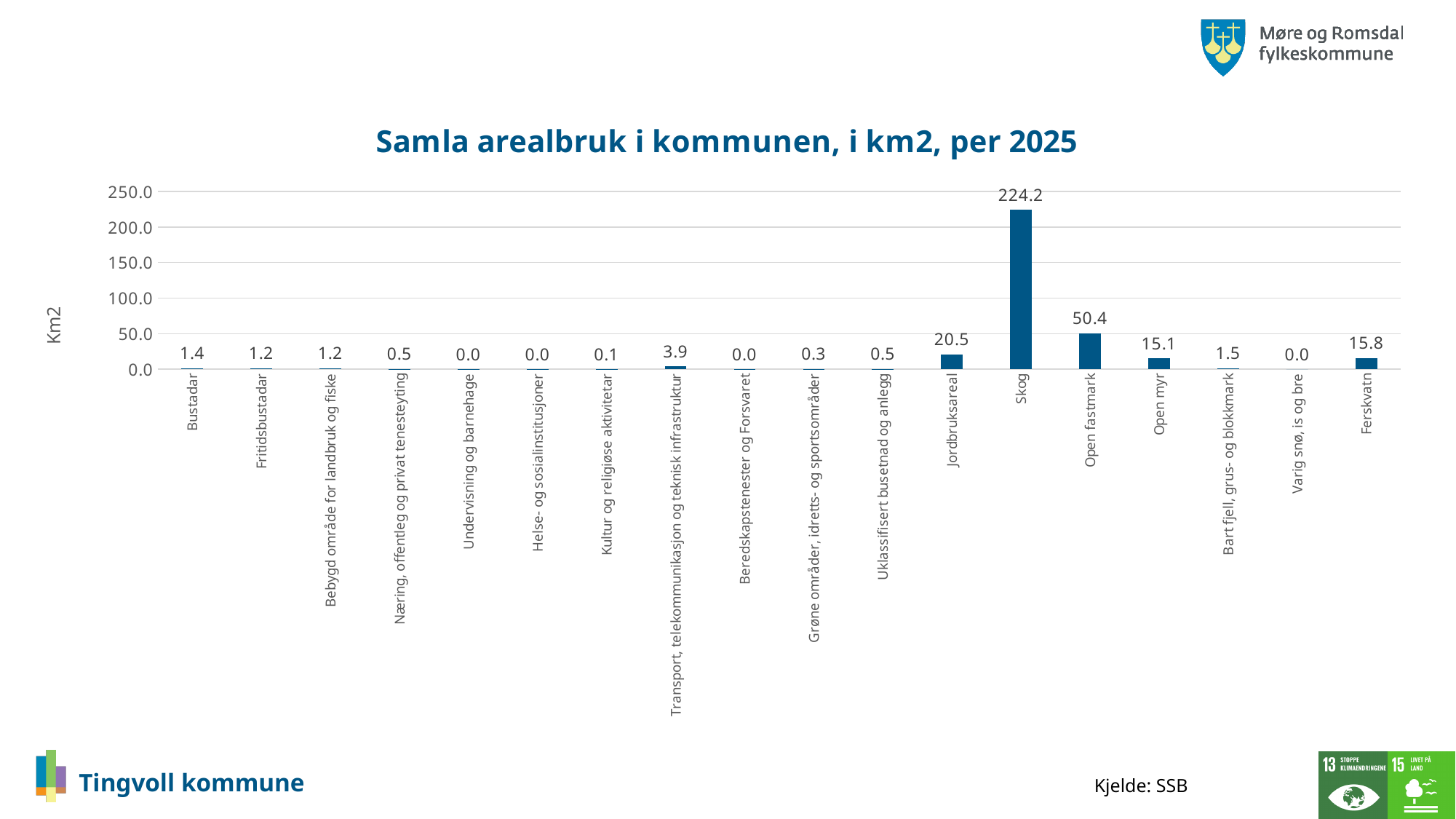
Which category has the highest value? Skog What is the value for Skog? 224.2 What is the value for Ferskvatn? 15.8 What is the value for Open fastmark? 50.4 Is the value for Skog greater or less than 200.0? greater What is the value for Transport, telekommunikasjon og teknisk infrastruktur? 3.9 How many categories are shown on the x axis? 18 What kind of chart is shown on the slide? Bar chart What is the difference between the values for Skog and Open fastmark? 173.8 Which is larger, the value for Open fastmark or the value for Jordbruksareal? Open fastmark What is the title of the chart? Samla arealbruk i kommunen, i km2, per 2025 What is the value for Jordbruksareal? 20.5